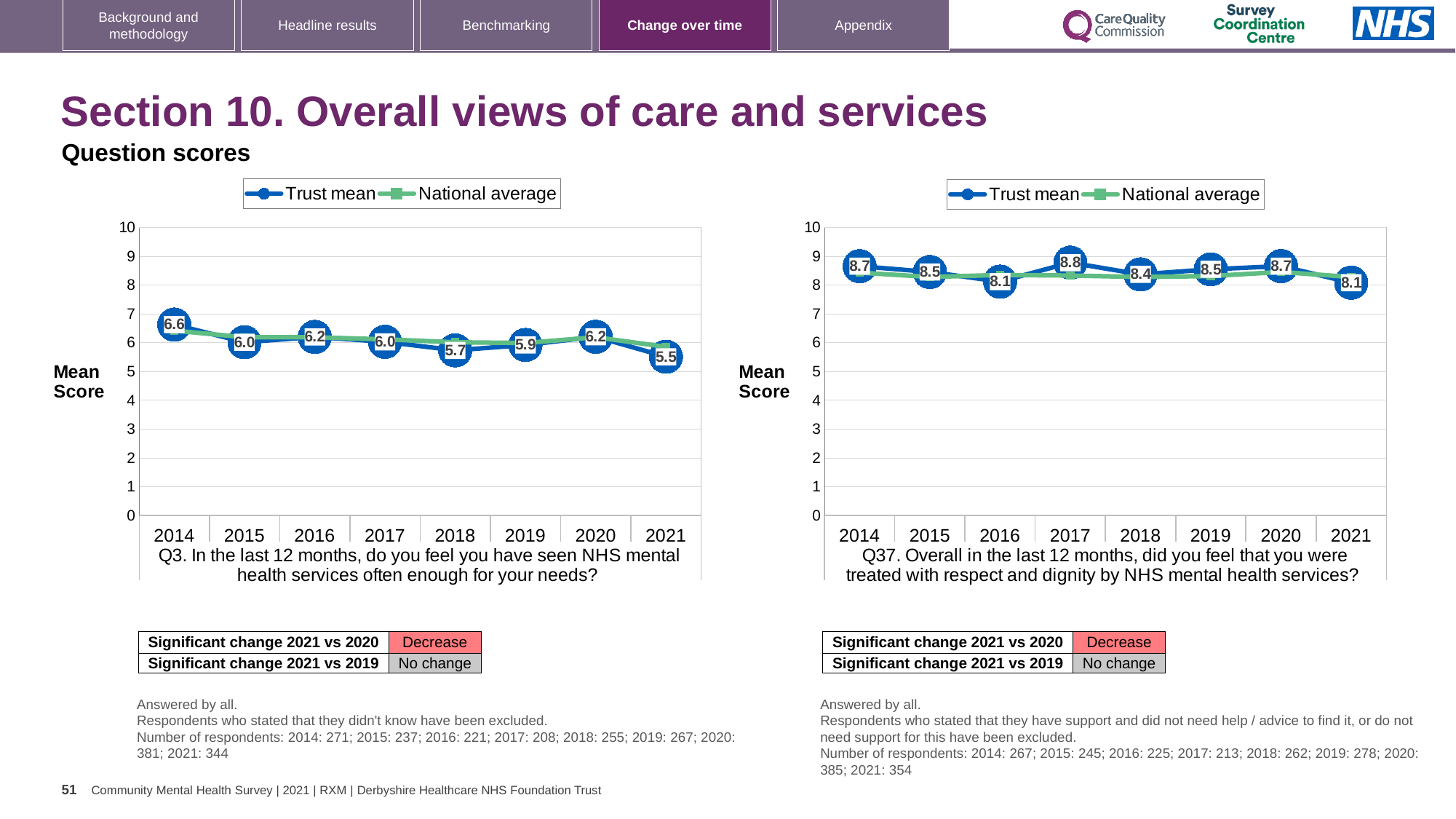
On the left chart (Q3), which year has the lowest Trust mean score? 2021 On the left chart (Q3), what is the Trust mean score for 2014? 6.6 On the right chart (Q37), what is the Trust mean score for 2021? 8.1 How many years are plotted on the x axis of the left chart (Q3)? 8 On the left chart (Q3), which year has the highest Trust mean score? 2014 On the right chart (Q37), is the Trust mean score for 2018 larger or smaller than for 2020? smaller How many series does the legend of the right chart (Q37) list? 2 What type of chart is used for the left chart (Q3)? Line chart On the right chart (Q37), what is the Trust mean score for 2017? 8.8 On the right chart (Q37), which year has the highest Trust mean score? 2017 On the left chart (Q3), what is the difference between the Trust mean scores for 2020 and 2021? 0.7 On the left chart (Q3), what is the Trust mean score for 2021? 5.5